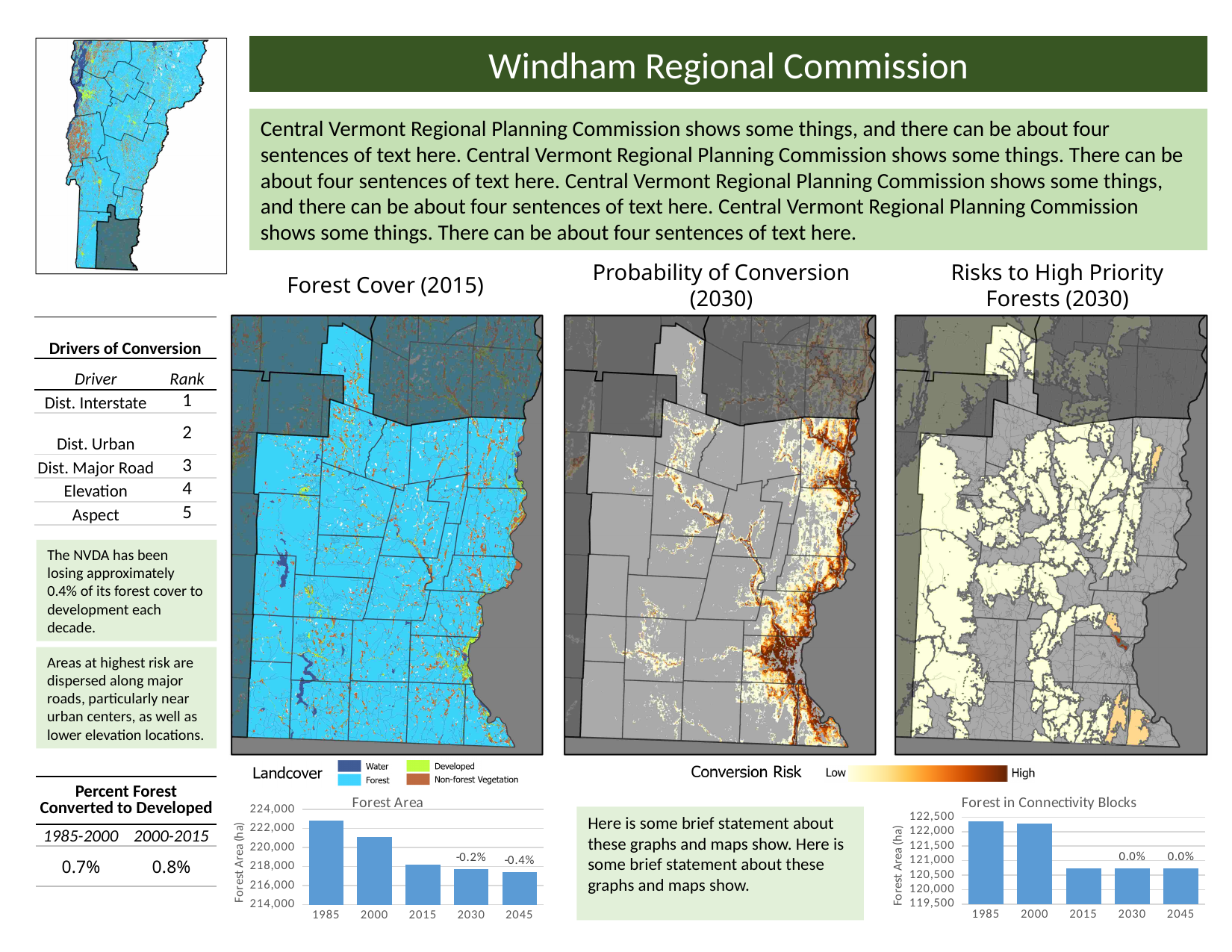
How many years are shown on the x axis of the "Forest Area" chart? 5 In the "Forest in Connectivity Blocks" chart, what data label is shown above the 2030 bar? 0.0% In the "Forest Area" chart, which is larger, the value for 2000 or the value for 2015? 2000 In the "Forest Area" chart, what data label is shown above the 2045 bar? -0.4% In the "Forest in Connectivity Blocks" chart, is the value for 2015 greater or less than 121,000? less In the "Forest Area" chart, what data label is shown above the 2030 bar? -0.2% In the "Forest Area" chart, which year has the highest forest area? 1985 In the "Forest Area" chart, is the value for 2045 greater or less than 218,000? less In the "Forest Area" chart, is the value for 1985 greater or less than 222,000? greater What is the y-axis title of the "Forest in Connectivity Blocks" chart? Forest Area (ha) What kind of chart is the "Forest Area" chart? bar chart In the "Forest Area" chart, do the values rise or fall from 1985 to 2045? fall